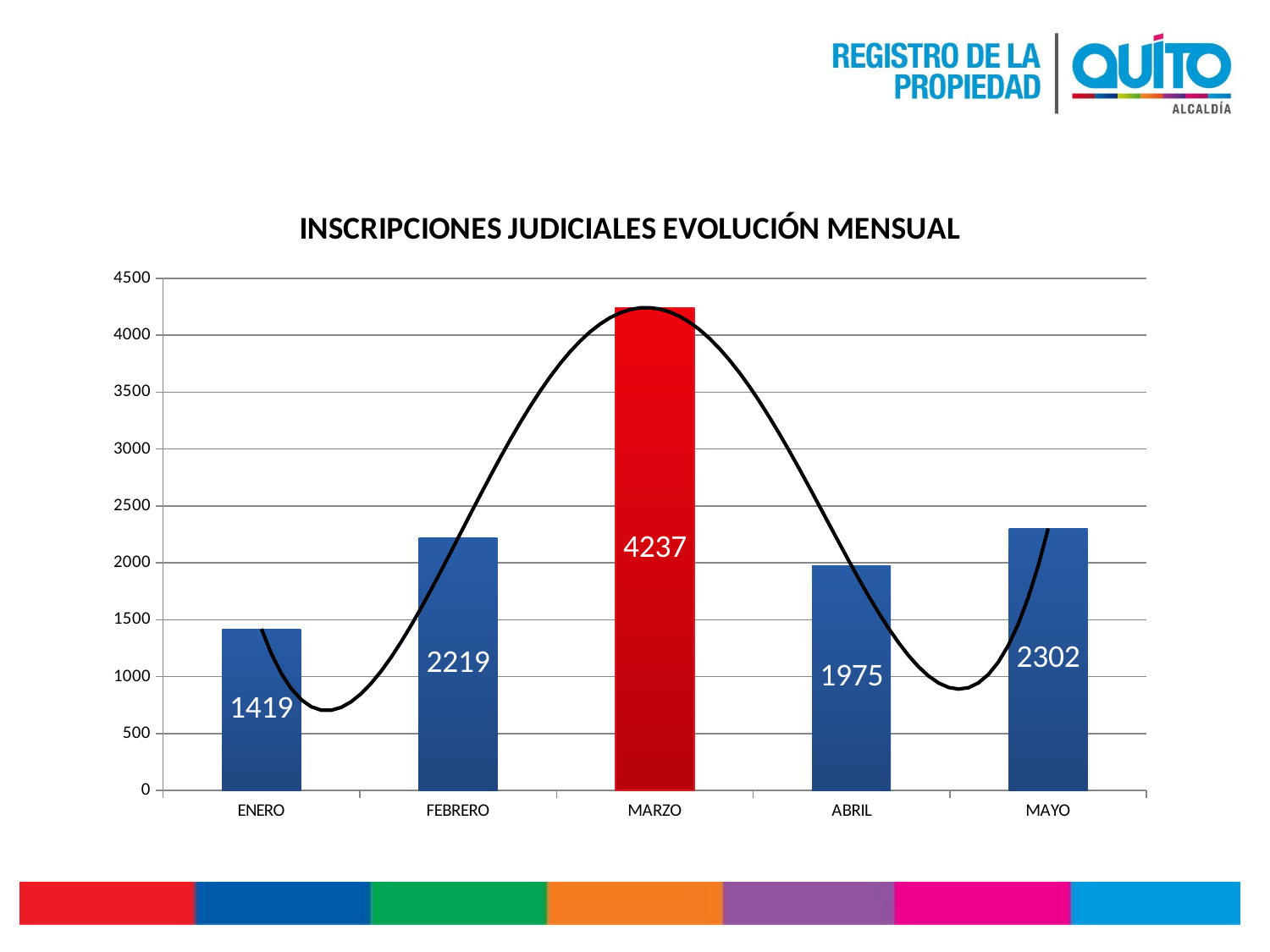
Which is larger, the value for FEBRERO or the value for ABRIL? FEBRERO Is the value for ABRIL greater or less than 2000? less What is the value for ENERO? 1419 How many months are shown on the x axis? 5 What is the value for MAYO? 2302 What is the difference between the values for MARZO and ABRIL? 2262 Which month has the highest value? MARZO What kind of chart is this? bar chart What is the value for MARZO? 4237 What is the difference between the values for FEBRERO and ENERO? 800 Which month has the lowest value? ENERO What is the title of the chart? INSCRIPCIONES JUDICIALES EVOLUCIÓN MENSUAL